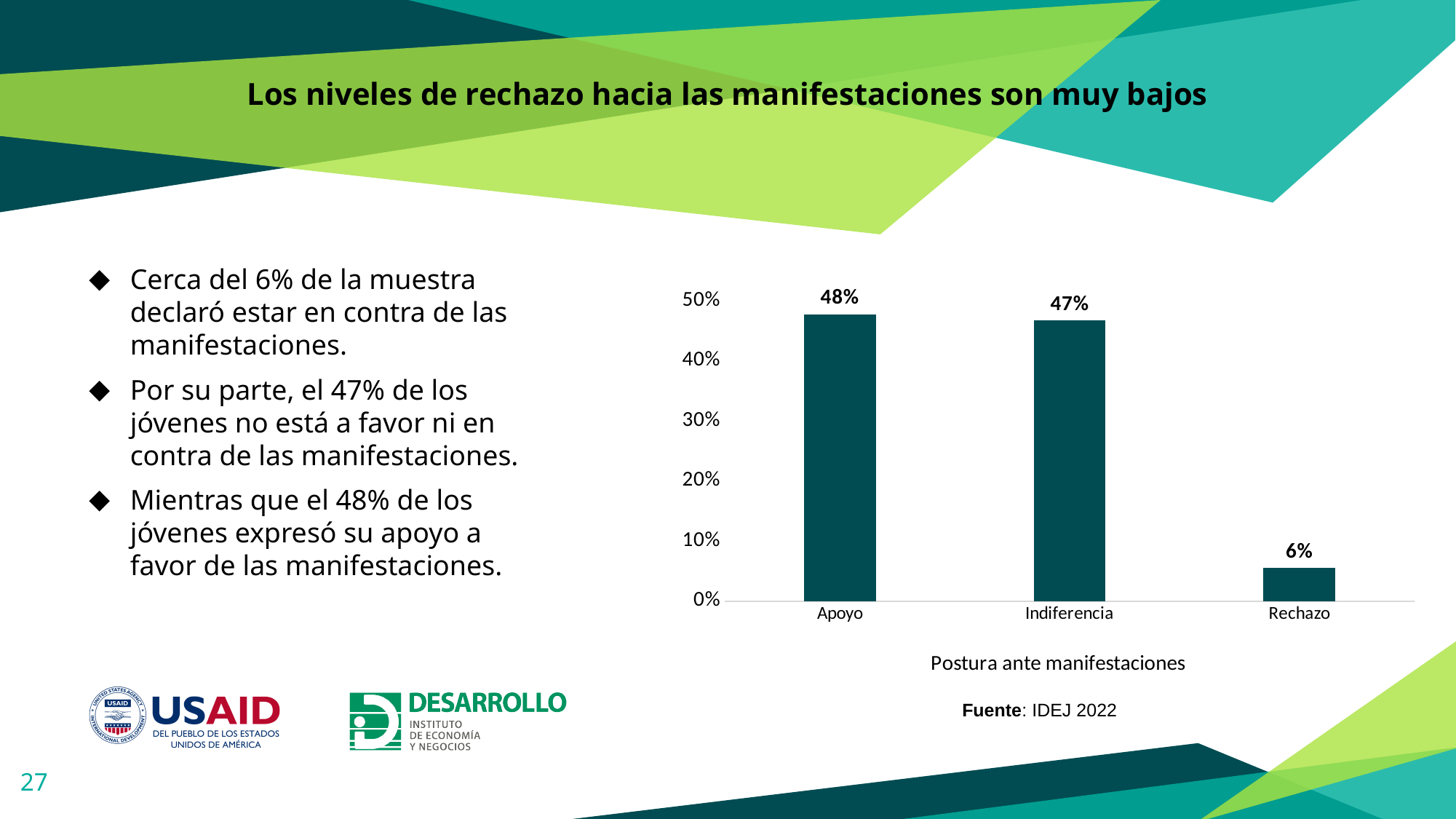
What is the value for Rechazo? 6% What kind of chart is shown on the slide? bar chart What is the difference between the values for Apoyo and Rechazo? 42% Which is larger, the value for Indiferencia or the value for Rechazo? Indiferencia What is the value for Apoyo? 48% What is the value for Indiferencia? 47% Is the value for Rechazo greater or less than 10%? less How many categories are shown on the x axis? 3 Which category has the lowest value? Rechazo Which category has the highest value? Apoyo What is the label of the x axis of the chart? Postura ante manifestaciones What is the difference between the values for Indiferencia and Rechazo? 41%